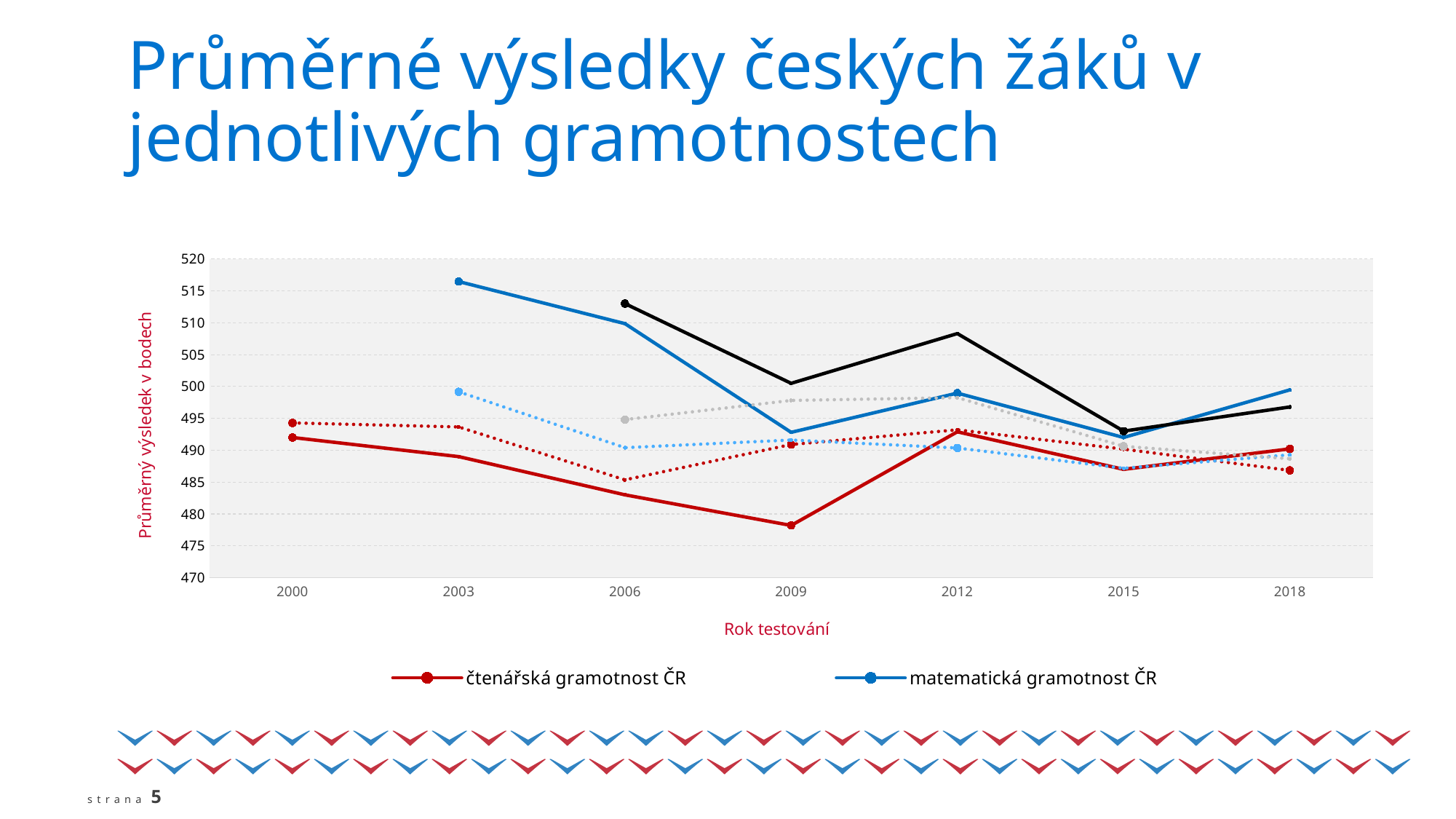
In 2006, which is larger: čtenářská gramotnost ČR or matematická gramotnost ČR? matematická gramotnost ČR Is the value for matematická gramotnost ČR in 2006 greater or less than 505? greater Is the value for matematická gramotnost ČR in 2003 greater or less than 515? greater Is the value for čtenářská gramotnost ČR in 2009 greater or less than 480? less In which year is čtenářská gramotnost ČR lowest? 2009 How many test years are shown on the x axis? 7 How many series does the legend list? 2 In which year is matematická gramotnost ČR highest? 2003 What is the title of the y axis? Průměrný výsledek v bodech What kind of chart is shown on the slide? line chart Does čtenářská gramotnost ČR rise or fall from 2000 to 2009? fall